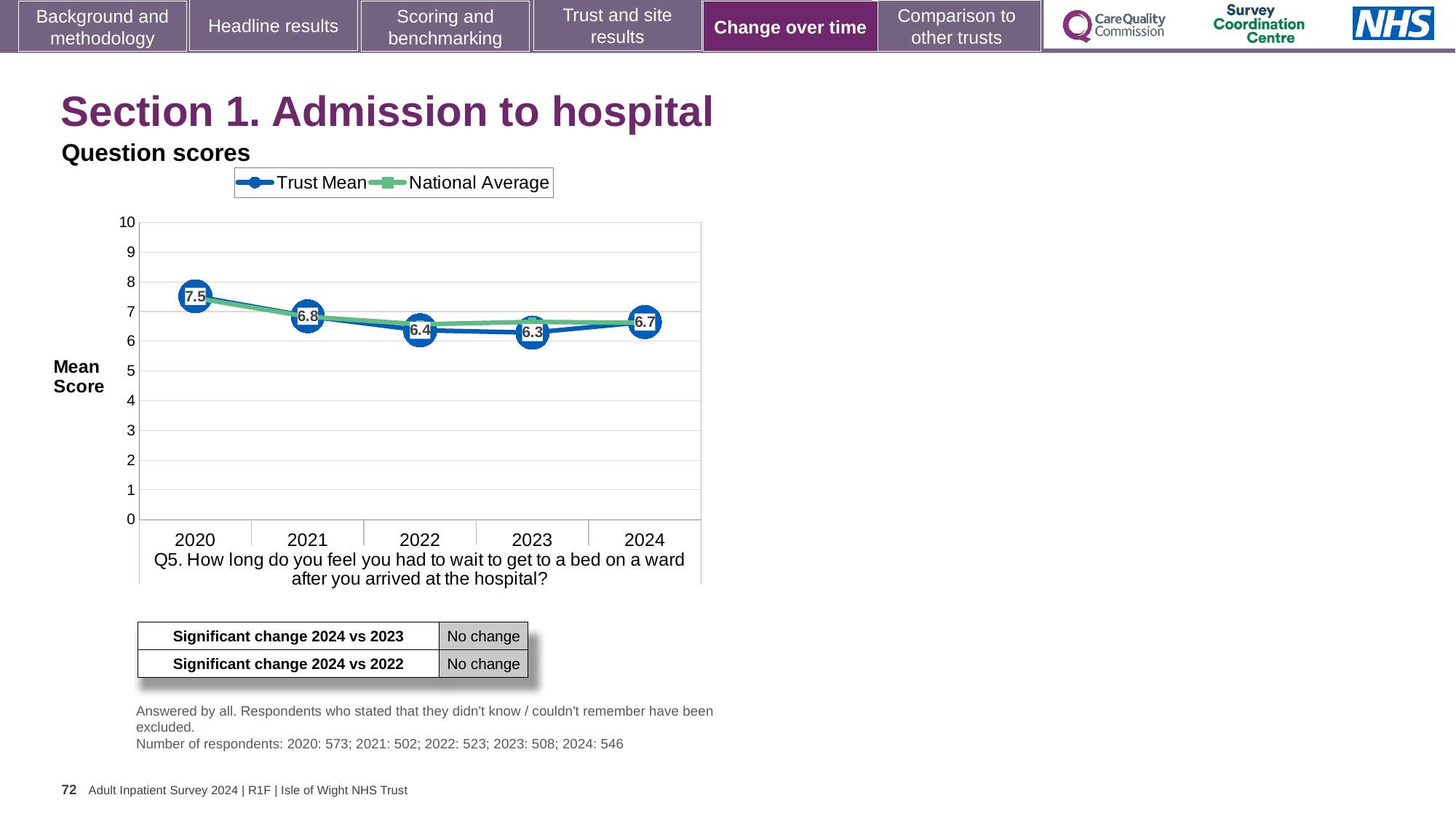
Which year has the larger Trust Mean score, 2022 or 2024? 2024 What is the Trust Mean score for 2023? 6.3 How many series does the legend list? 2 What is the Trust Mean score for 2020? 7.5 In which year is the Trust Mean score highest? 2020 How many years are plotted on the x axis? 5 In which year is the Trust Mean score lowest? 2023 What kind of chart is shown? Line chart Does the Trust Mean score rise or fall from 2020 to 2023? Fall What is the Trust Mean score for 2024? 6.7 Is the National Average value for 2020 greater or less than 7? greater What is the difference between the Trust Mean scores for 2020 and 2021? 0.7